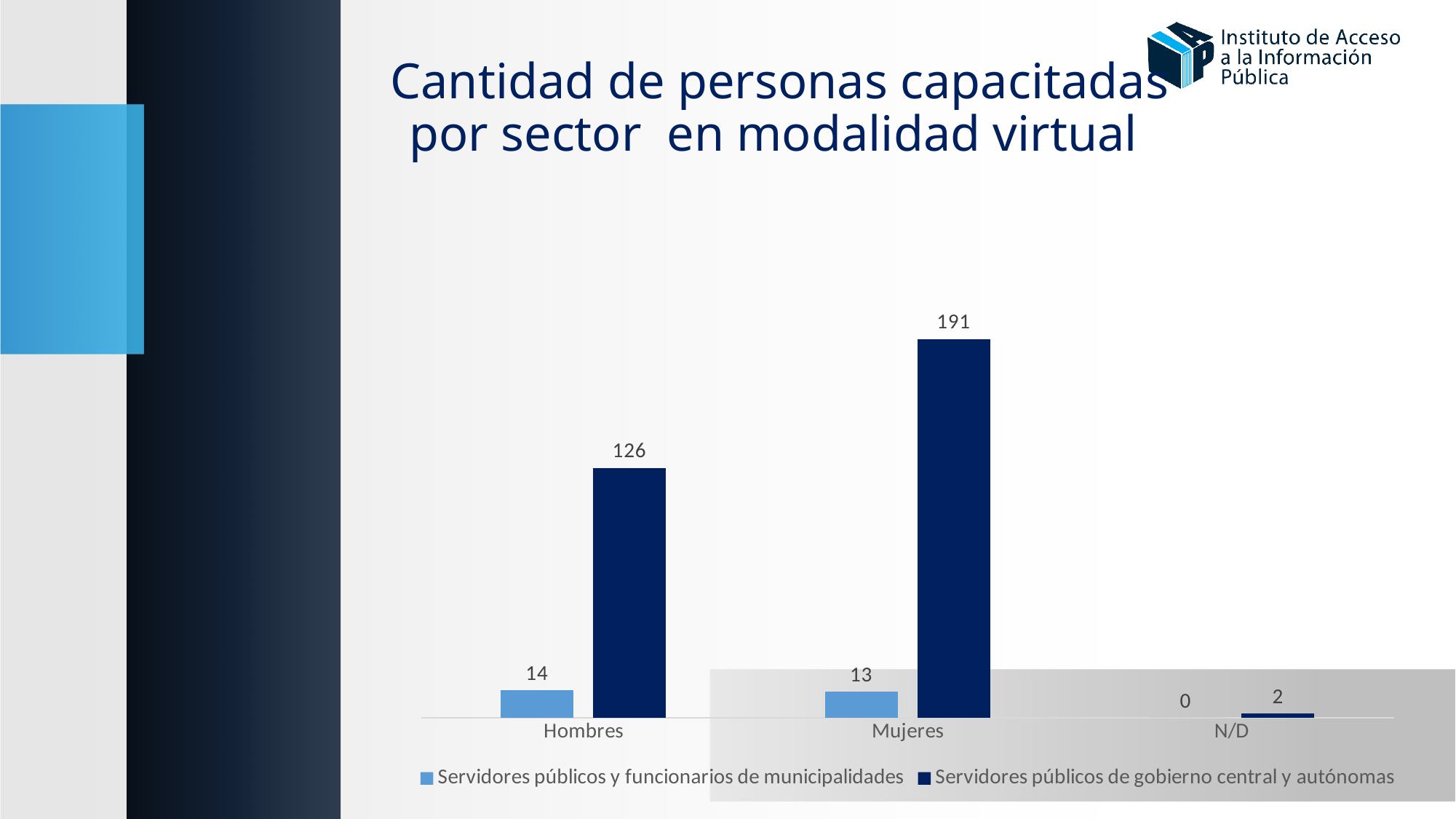
Which is larger: the Hombres value or the Mujeres value in the 'Servidores públicos y funcionarios de municipalidades' series? Hombres How many categories are shown on the x axis? 3 What is the value for Mujeres in the 'Servidores públicos y funcionarios de municipalidades' series? 13 What is the value for Hombres in the 'Servidores públicos de gobierno central y autónomas' series? 126 What kind of chart is shown on the slide? Bar chart What is the title of the slide's chart? Cantidad de personas capacitadas por sector en modalidad virtual How many series does the legend list? 2 What is the value for N/D in the 'Servidores públicos de gobierno central y autónomas' series? 2 Which category has the lowest value in the 'Servidores públicos y funcionarios de municipalidades' series? N/D Which category has the highest value in the 'Servidores públicos de gobierno central y autónomas' series? Mujeres Which series is shown in light blue? Servidores públicos y funcionarios de municipalidades What is the difference between the Mujeres and Hombres values in the 'Servidores públicos de gobierno central y autónomas' series? 65